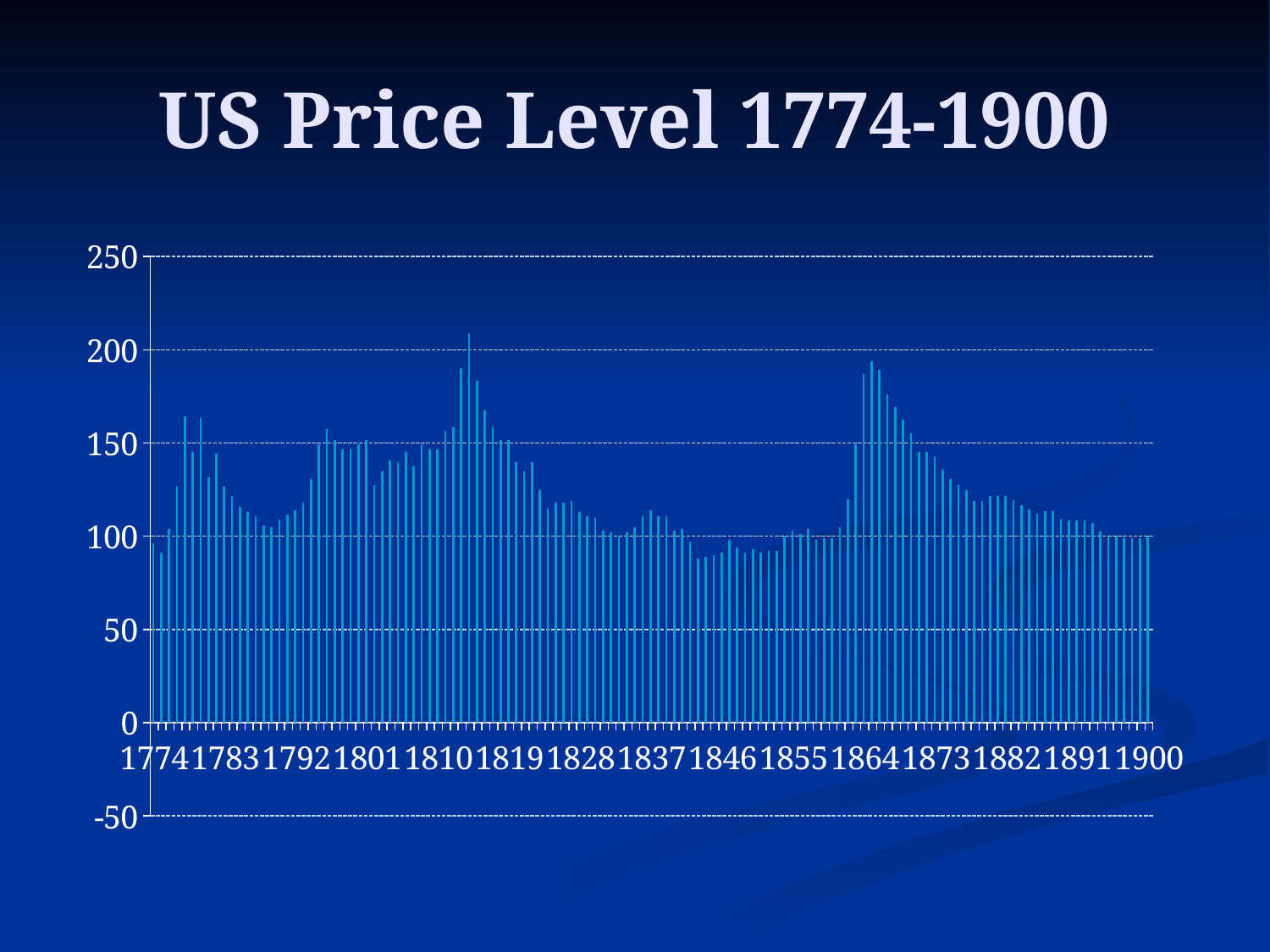
Is the value for 1864 greater or less than 150? greater How many year labels are shown on the horizontal axis? 15 Is the highest value on the chart greater or less than 150? greater Is the value for 1873 greater or less than 150? less What is the title of the chart? US Price Level 1774-1900 What kind of chart is shown on the slide? bar chart Which is larger, the value for 1864 or the value for 1846? 1864 Do the values rise or fall from 1864 to 1873? fall What is the lowest value shown on the vertical axis? -50